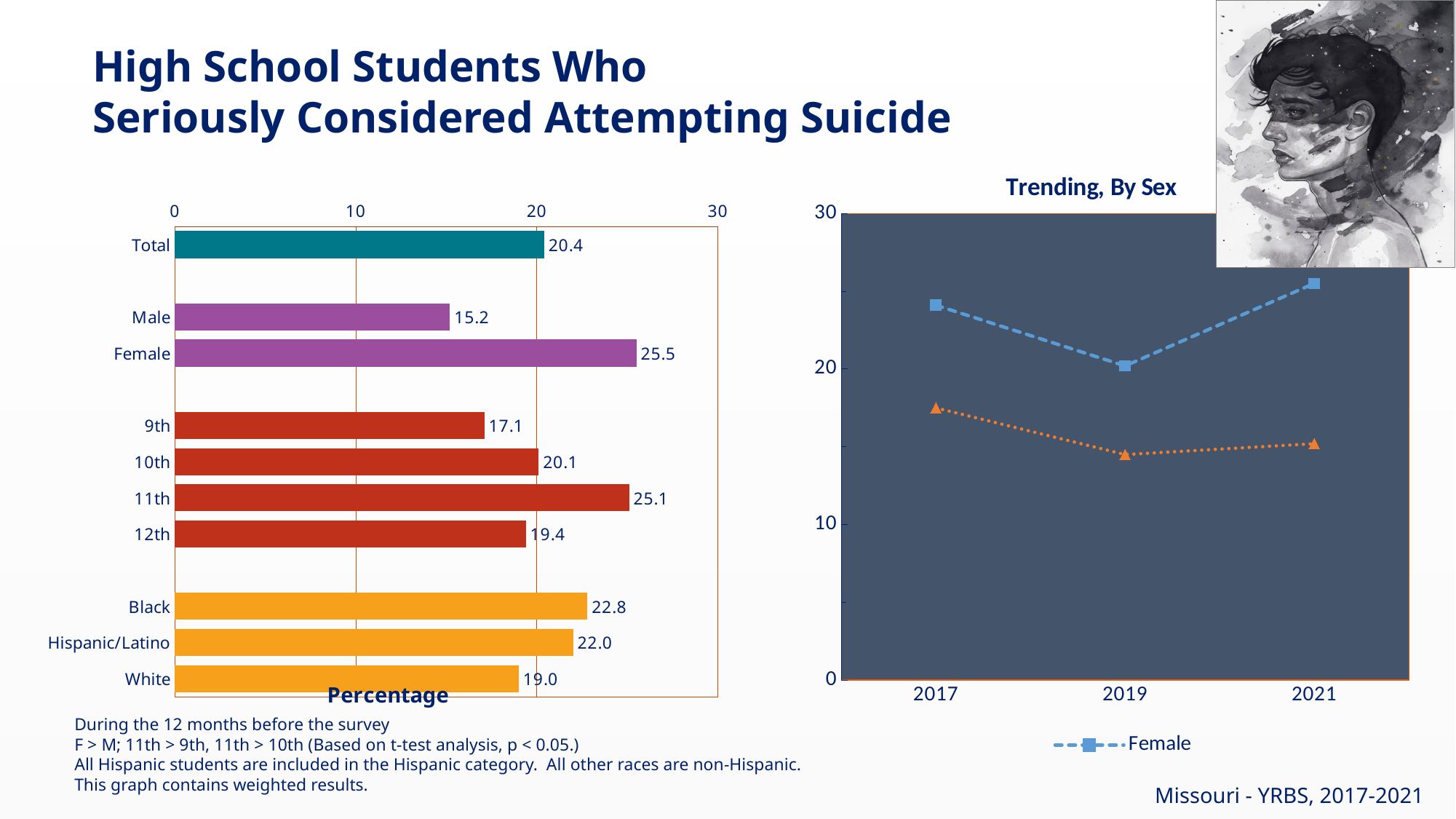
In the bar chart on the left, which category has the lowest value? Male In the bar chart on the left, which grade has the highest value? 11th In the 'Trending, By Sex' chart, is the Female value for 2017 greater or less than 20? greater What kind of chart is the chart on the left? Bar chart How many bars are shown in the bar chart on the left? 10 In the bar chart on the left, which is larger, the value for Black or the value for White? Black In the 'Trending, By Sex' chart, how many years are plotted on the x axis? 3 In the bar chart on the left, what is the value for 11th grade? 25.1 In the bar chart on the left, what is the value for Hispanic/Latino? 22.0 In the 'Trending, By Sex' chart, is the value of the orange dotted series for 2019 greater or less than 20? less In the bar chart on the left, what is the value for Female? 25.5 In the bar chart on the left, what is the difference between the Female and Male values? 10.3